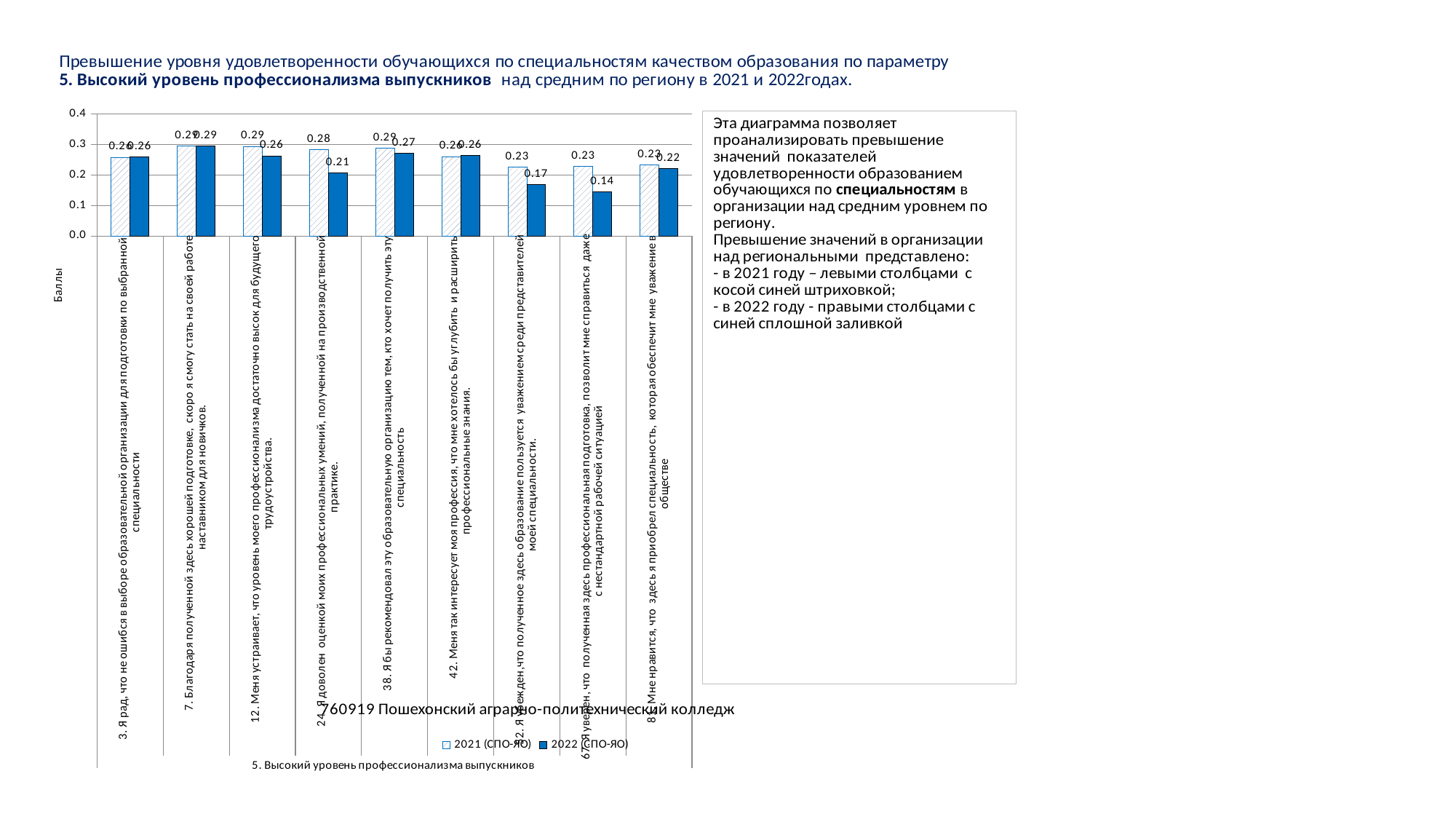
Which statement has the highest 2022 (СПО-ЯО) value? 7. Благодаря полученной здесь хорошей подготовке, скоро я смогу стать на своей работе наставником для новичков What kind of chart is shown on the slide? bar chart What is the 2022 (СПО-ЯО) value for statement 52 ("Я убежден, что полученное здесь образование пользуется уважением среди представителей моей специальности")? 0.17 What is the 2021 (СПО-ЯО) value for statement 24 ("Я доволен оценкой моих профессиональных умений, полученной на производственной практике")? 0.28 How many series does the legend list? 2 For statement 67, which is larger: the 2021 (СПО-ЯО) value or the 2022 (СПО-ЯО) value? 2021 (СПО-ЯО) What is the difference between the 2021 and 2022 values for statement 38 ("Я бы рекомендовал эту образовательную организацию...")? 0.02 What label is shown on the vertical axis of the chart? Баллы What is the 2022 (СПО-ЯО) value for statement 67 ("Я уверен, что полученная здесь профессиональная подготовка, позволит мне справиться даже с нестандартной рабочей ситуацией")? 0.14 Which statement has the lowest 2022 (СПО-ЯО) value? 67. Я уверен, что полученная здесь профессиональная подготовка, позволит мне справиться даже с нестандартной рабочей ситуацией What is the difference between the 2021 and 2022 values for statement 24 ("Я доволен оценкой моих профессиональных умений...")? 0.07 How many categories (statements) are plotted along the x axis? 9